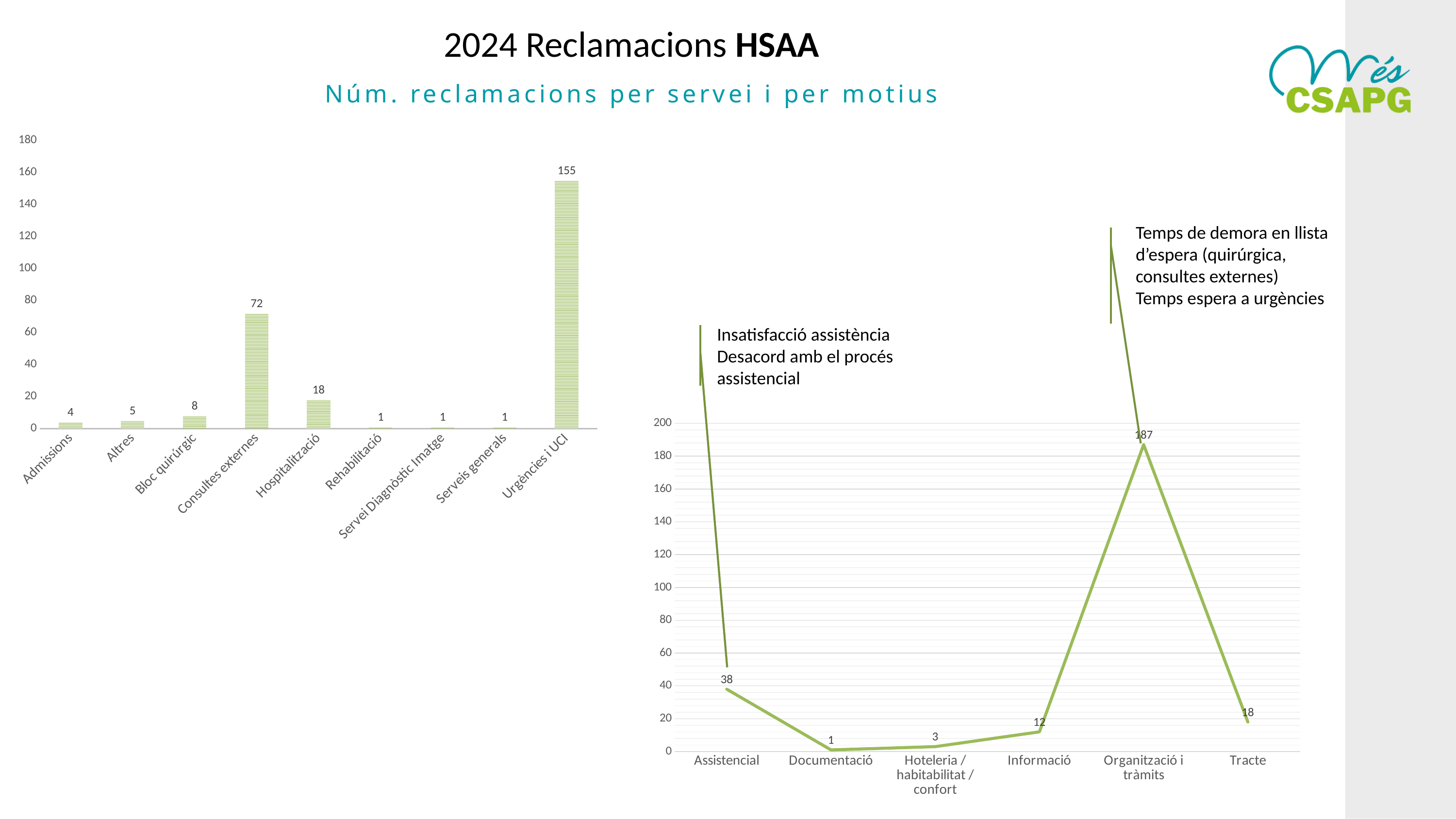
In the bar chart on the left, what is the value for Consultes externes? 72 In the bar chart on the left, which category has the highest value? Urgències i UCI In the bar chart on the left, which is larger, Altres or Bloc quirúrgic? Bloc quirúrgic In the line chart on the right, what is the value for Organització i tràmits? 187 In the bar chart on the left, what is the value for Hospitalització? 18 In the line chart on the right, what is the difference between Assistencial and Tracte? 20 What kind of chart is the chart on the right? line chart In the bar chart on the left, what is the difference between Urgències i UCI and Consultes externes? 83 In the bar chart on the left, how many categories are shown on the x axis? 9 In the line chart on the right, which category has the lowest value? Documentació In the line chart on the right, how many categories are shown on the x axis? 6 What kind of chart is the chart on the left? bar chart